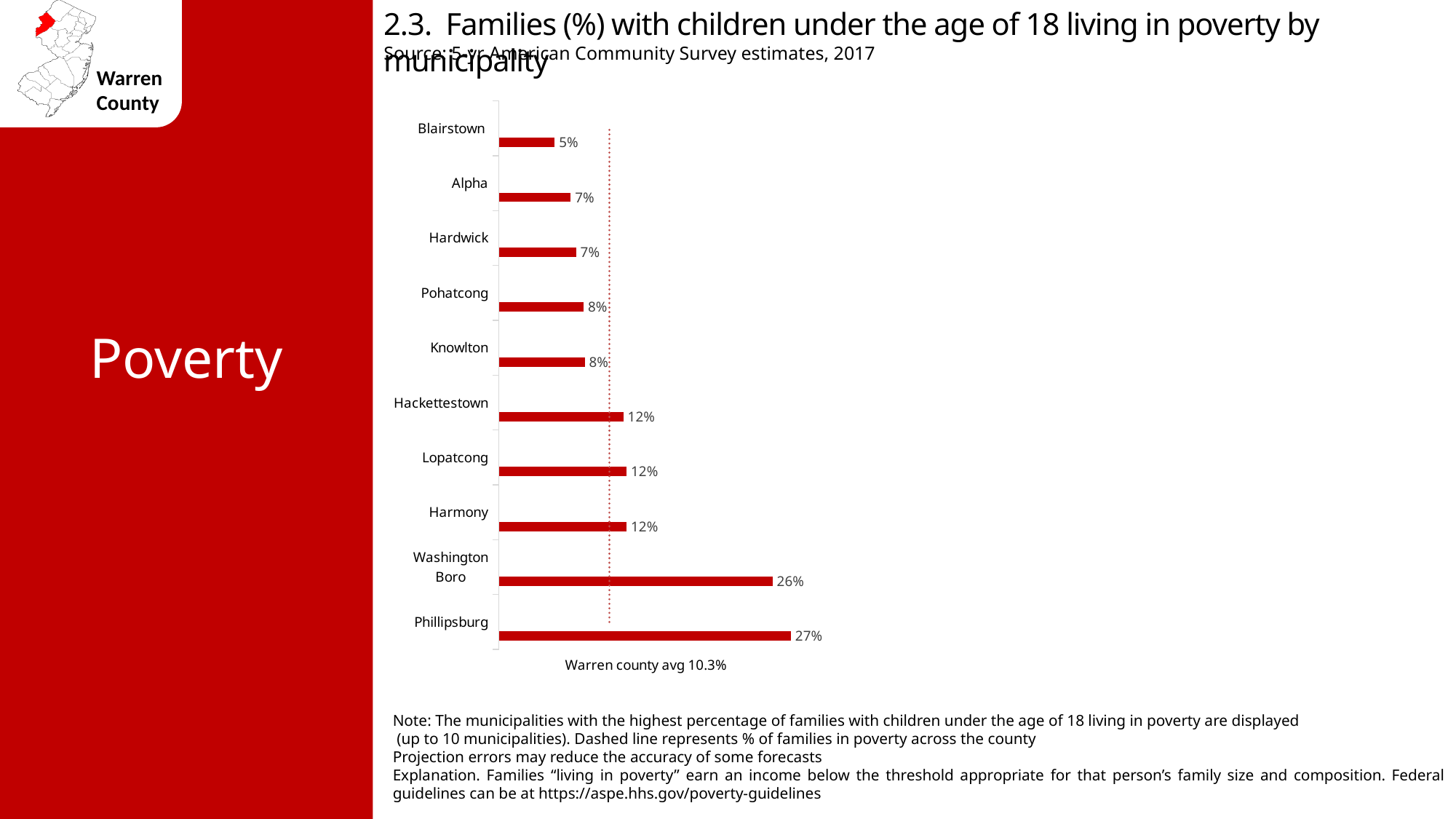
What is the value shown for Blairstown? 5% What is the difference between the values for Washington Boro and Harmony? 14% What percentage of families with children under 18 are living in poverty in Phillipsburg? 27% What is the value shown for Hackettestown? 12% Which municipality has the lowest percentage shown on the chart? Blairstown What Warren county average does the dashed line represent? 10.3% How many municipalities are shown on the chart? 10 What is the difference between the values for Phillipsburg and Blairstown? 22% What is the value shown for Washington Boro? 26% Which municipality has the highest percentage of families with children under 18 living in poverty? Phillipsburg Which has a higher value, Alpha or Lopatcong? Lopatcong What kind of chart is shown on the slide? Bar chart